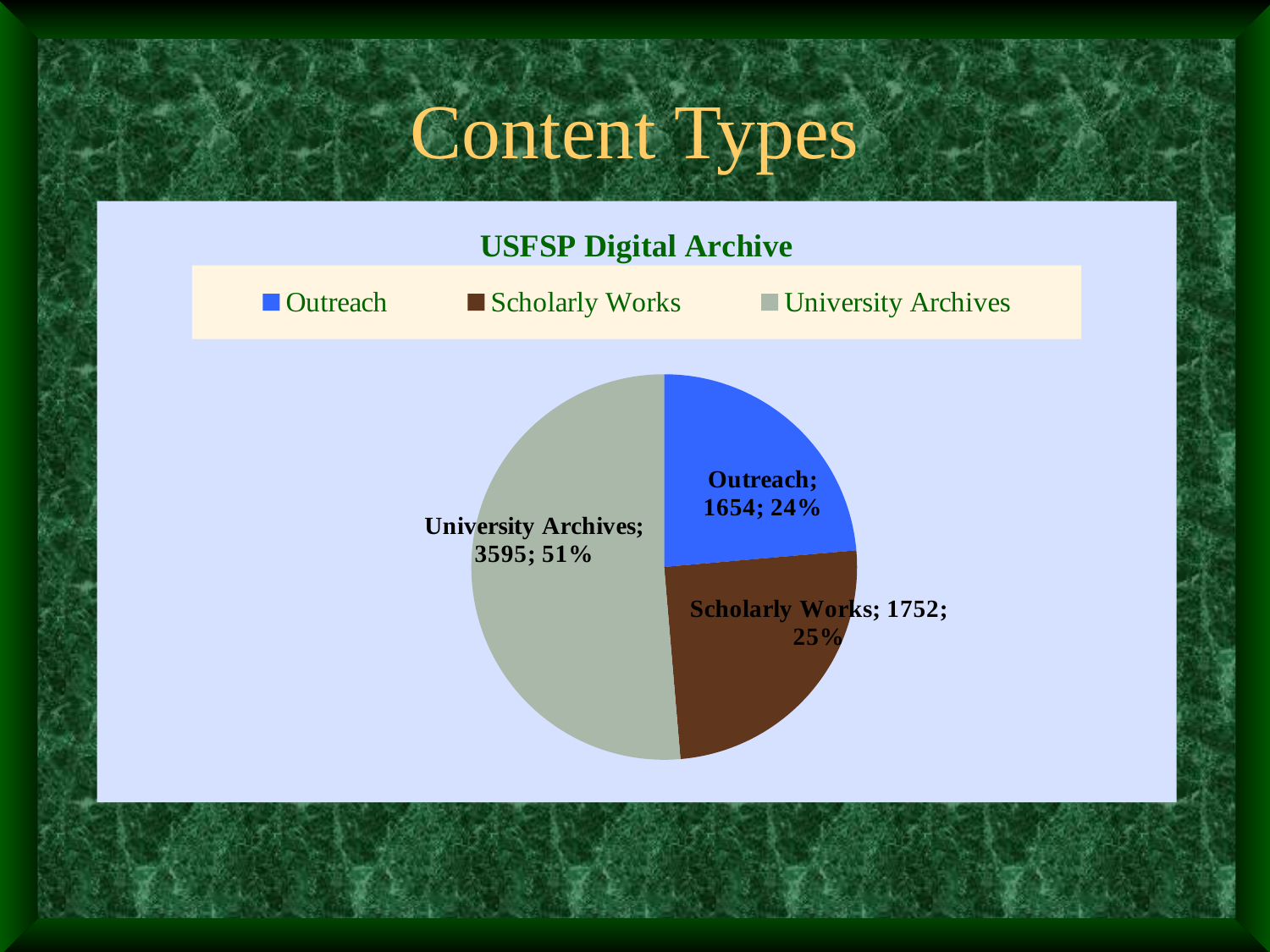
How many entries does the legend list? 3 What is the value for Outreach? 1654 What share of the pie does Outreach represent? 24% What is the value for Scholarly Works? 1752 What is the difference between the values for University Archives and Scholarly Works? 1843 What kind of chart is shown on the slide? pie chart Which category has the largest slice? University Archives What is the value for University Archives? 3595 Which category has the smallest slice? Outreach What share of the pie does University Archives represent? 51% How many slices does the pie chart have? 3 What is the title of the chart? USFSP Digital Archive